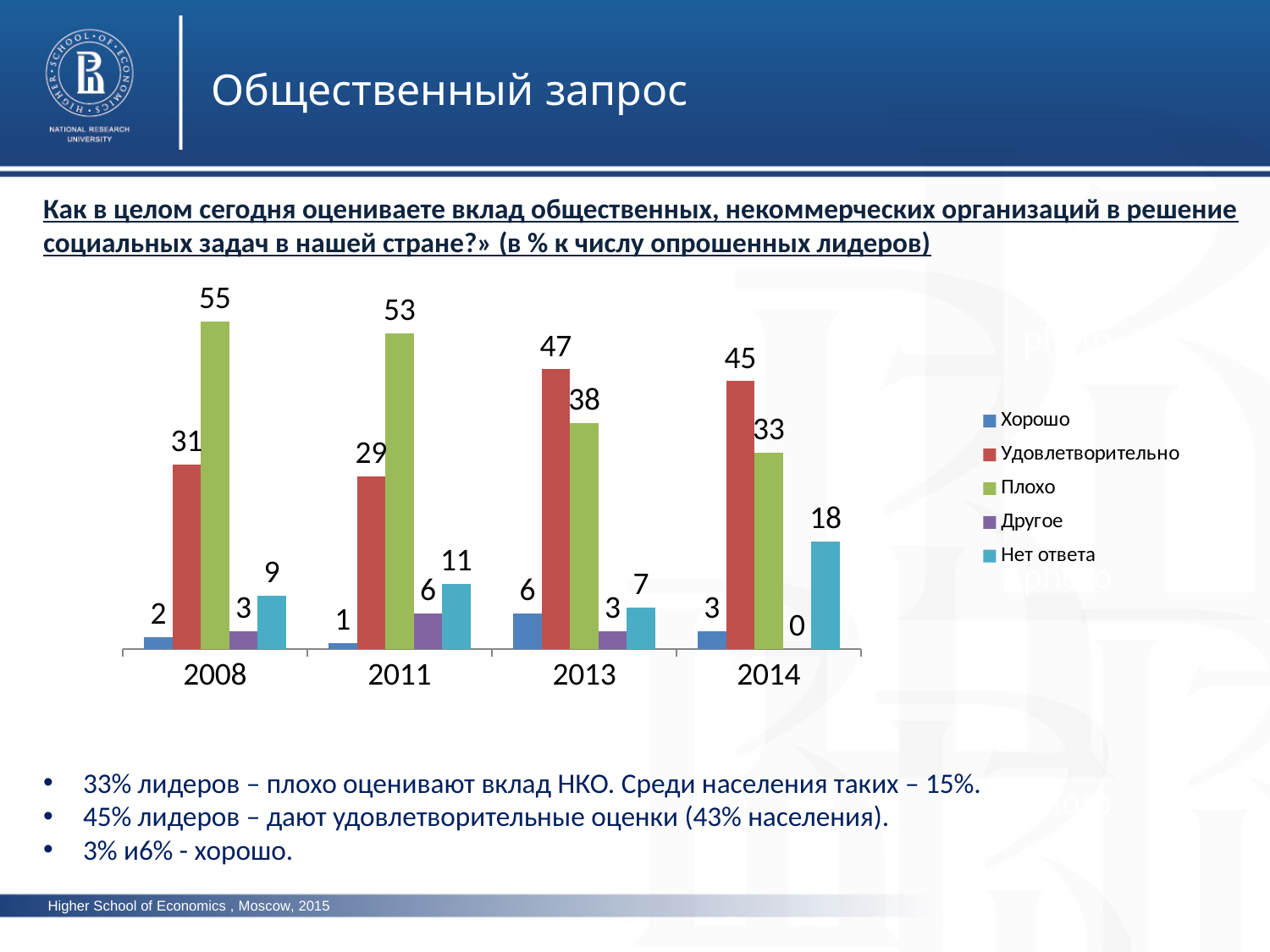
What is the value for Другое in 2014? 0 In which year is the value for Удовлетворительно highest? 2013 What is the value for Удовлетворительно in 2014? 45 How many series does the legend list? 5 What kind of chart is shown on the slide? bar chart What is the value for Нет ответа in 2011? 11 Does the value for Плохо rise or fall from 2008 to 2014? fall What is the value for Плохо in 2008? 55 What is the difference between Плохо and Удовлетворительно in 2013? 9 In which year is the value for Хорошо lowest? 2011 Which is larger in 2011: Плохо or Удовлетворительно? Плохо How many years are shown on the x axis? 4